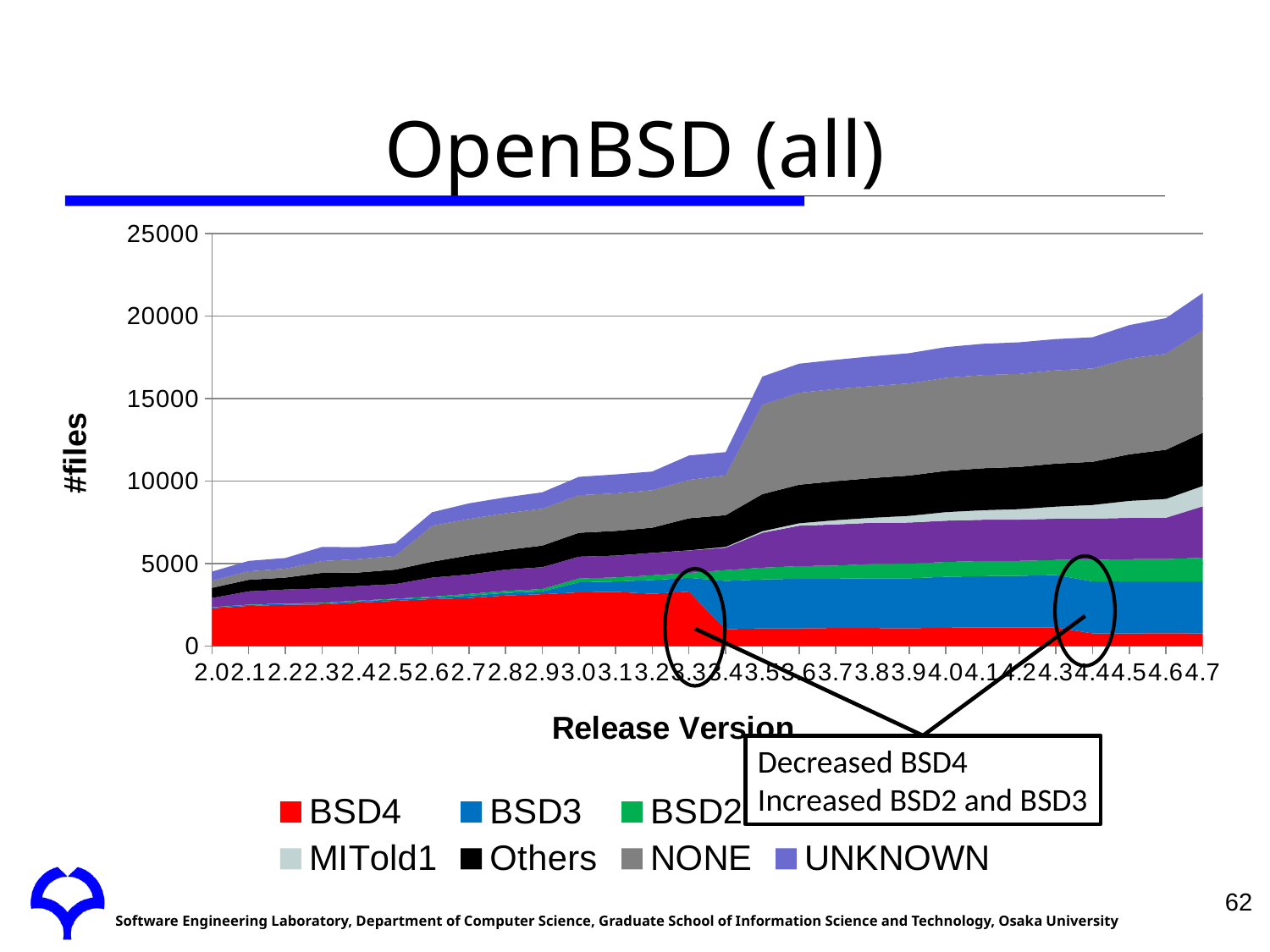
What is the label of the x axis? Release Version Does the total number of files rise or fall as the release version increases? Rises What is the title of the chart? OpenBSD (all) Which release version has the highest total number of files? 4.7 Is the number of BSD3 files larger at release 2.0 or at release 4.0? 4.0 Is the total number of files at release 2.0 greater or less than 5000? less Is the number of BSD4 files larger at release 3.2 or at release 4.7? 3.2 How many release versions are shown along the x axis? 28 Is the total number of files at release 3.5 greater or less than 15000? greater Which release version has the lowest total number of files? 2.0 Is the total number of files at release 4.7 greater or less than 20000? greater What kind of chart is shown on the slide? Stacked area chart